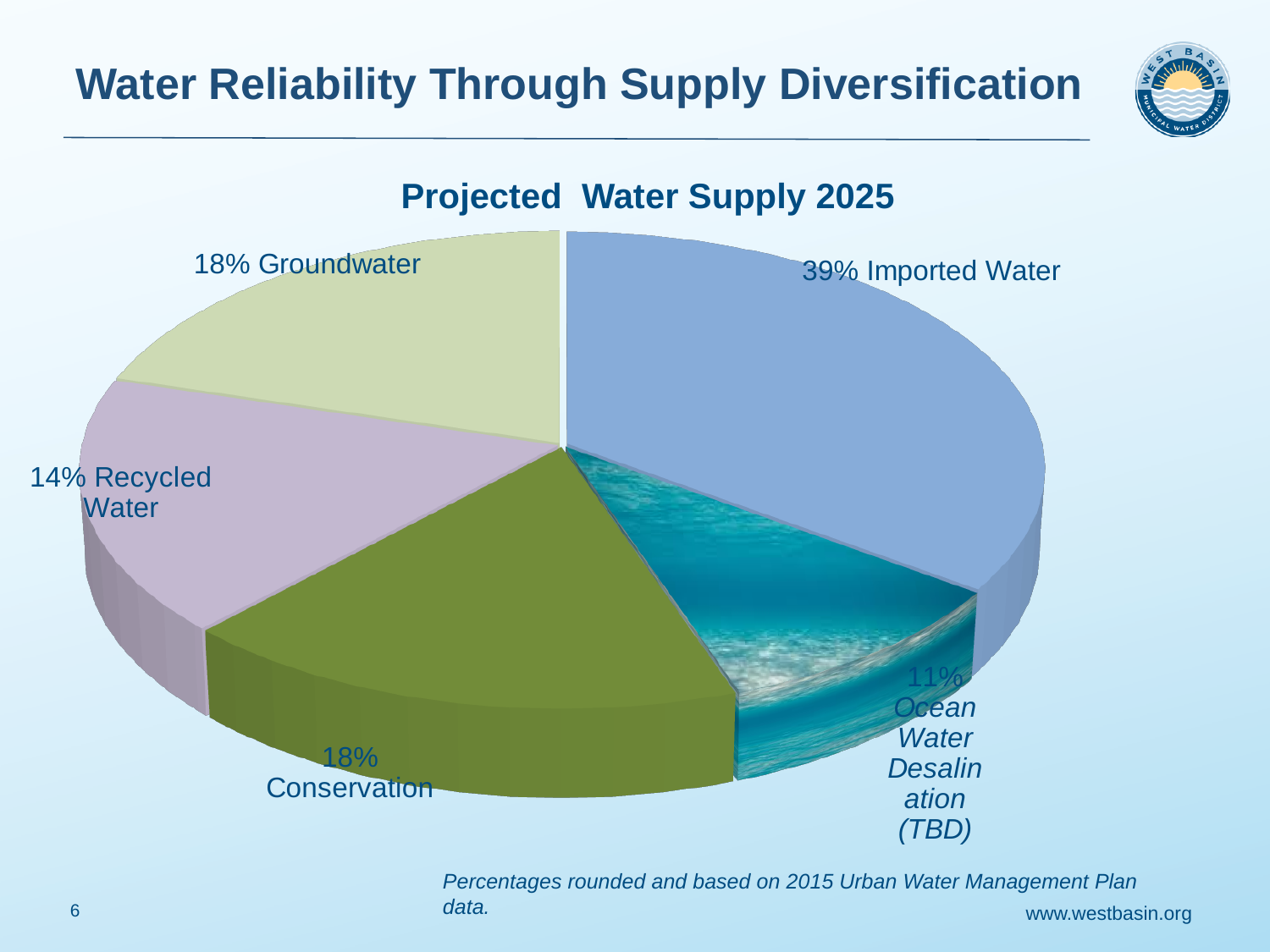
What share of the projected 2025 water supply is Imported Water? 39% What is the difference in percentage points between Imported Water and Recycled Water? 25 How many slices does the pie chart have? 5 Which source has the largest share of the projected 2025 water supply? Imported Water Which is larger, the share for Conservation or the share for Recycled Water? Conservation What kind of chart is shown on the slide? pie chart Which source has the smallest share of the projected 2025 water supply? Ocean Water Desalination (TBD) What share of the projected 2025 water supply is Groundwater? 18% What share of the projected 2025 water supply is Ocean Water Desalination (TBD)? 11% Which two sources have the same share of the projected 2025 water supply? Groundwater and Conservation What is the title of the pie chart? Projected Water Supply 2025